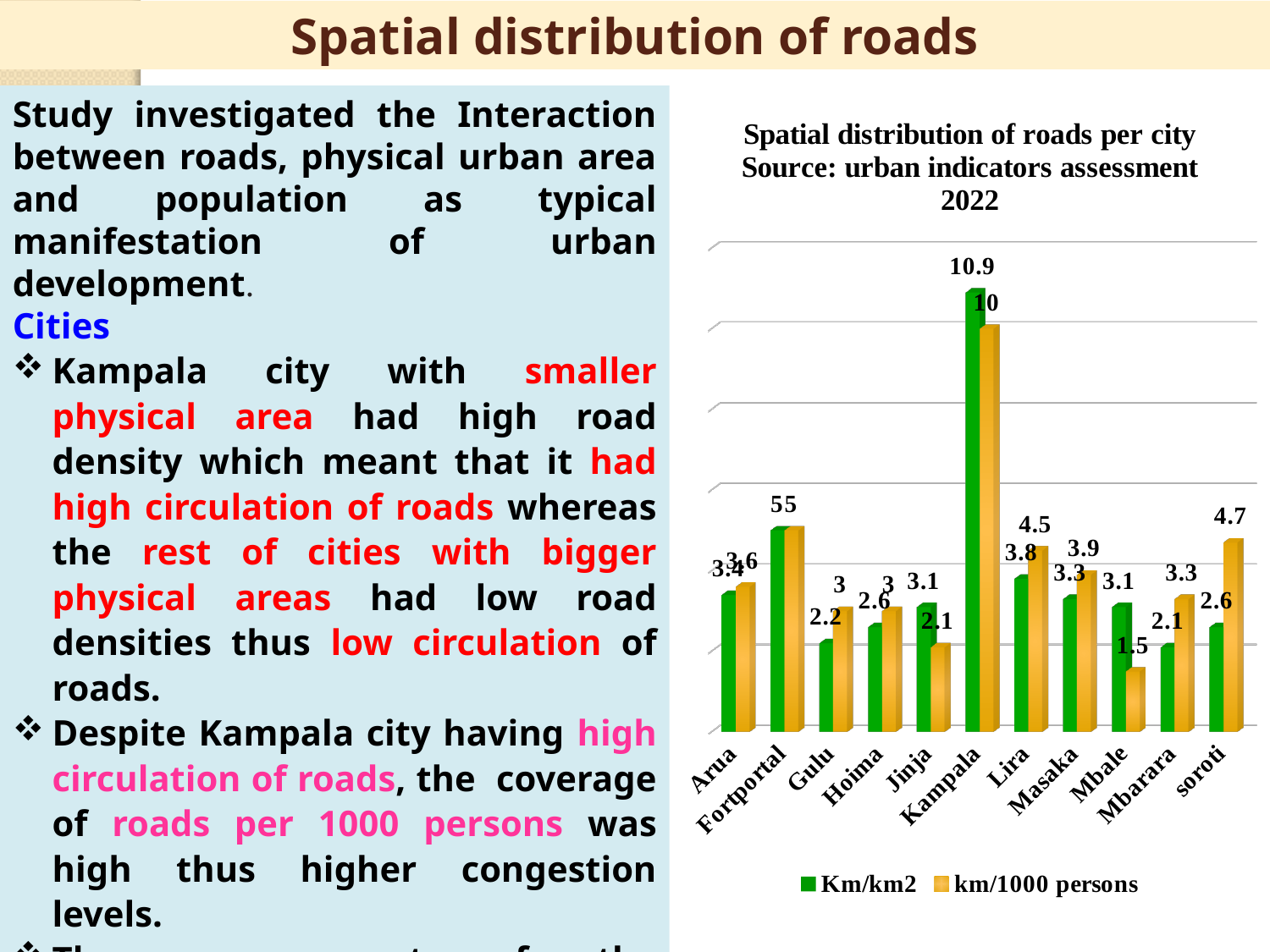
How many cities are shown on the x axis of the chart? 11 What is the km/1000 persons value for soroti? 4.7 What kind of chart is shown on the slide? bar chart Which city has the highest Km/km2 value? Kampala What is the difference between the Km/km2 value and the km/1000 persons value for Kampala? 0.9 What is the Km/km2 value for Kampala? 10.9 How many series does the legend list? 2 What are the two series named in the chart legend? Km/km2 and km/1000 persons What is the km/1000 persons value for Kampala? 10 What is the km/1000 persons value for Mbale? 1.5 For Lira, which is larger: the Km/km2 value or the km/1000 persons value? km/1000 persons Which city has the lowest km/1000 persons value? Mbale